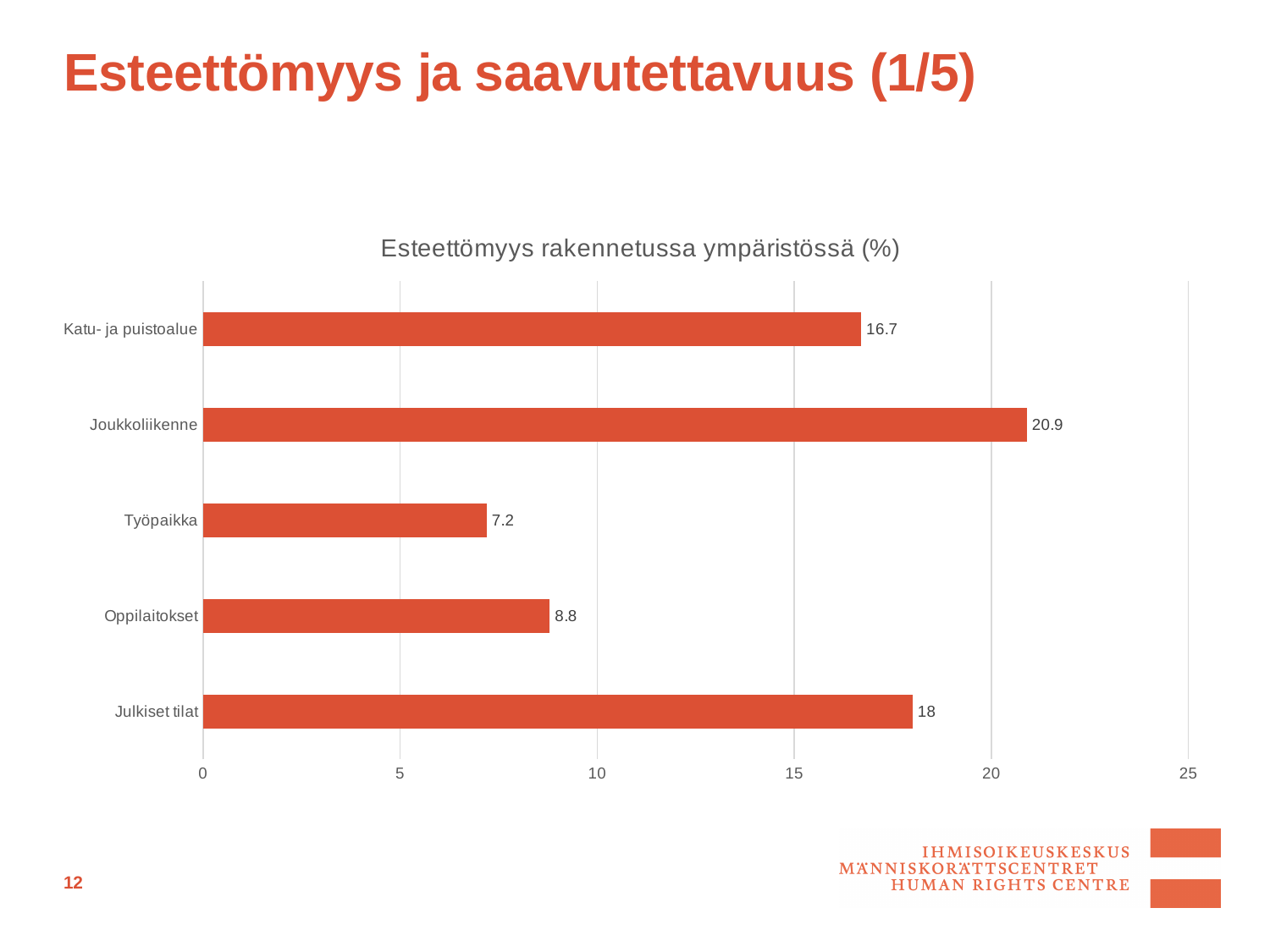
What is the value for Joukkoliikenne? 20.9 How many categories are shown in the chart? 5 What is the difference between the values for Joukkoliikenne and Katu- ja puistoalue? 4.2 Is the value for Julkiset tilat greater or less than 15? greater Which category has the lowest value? Työpaikka What is the value for Työpaikka? 7.2 What is the maximum value shown on the horizontal axis? 25 Which category has the highest value? Joukkoliikenne Which is larger, the value for Oppilaitokset or the value for Työpaikka? Oppilaitokset What is the title of the chart? Esteettömyys rakennetussa ympäristössä (%) What is the value for Julkiset tilat? 18 What kind of chart is shown on the slide? Bar chart